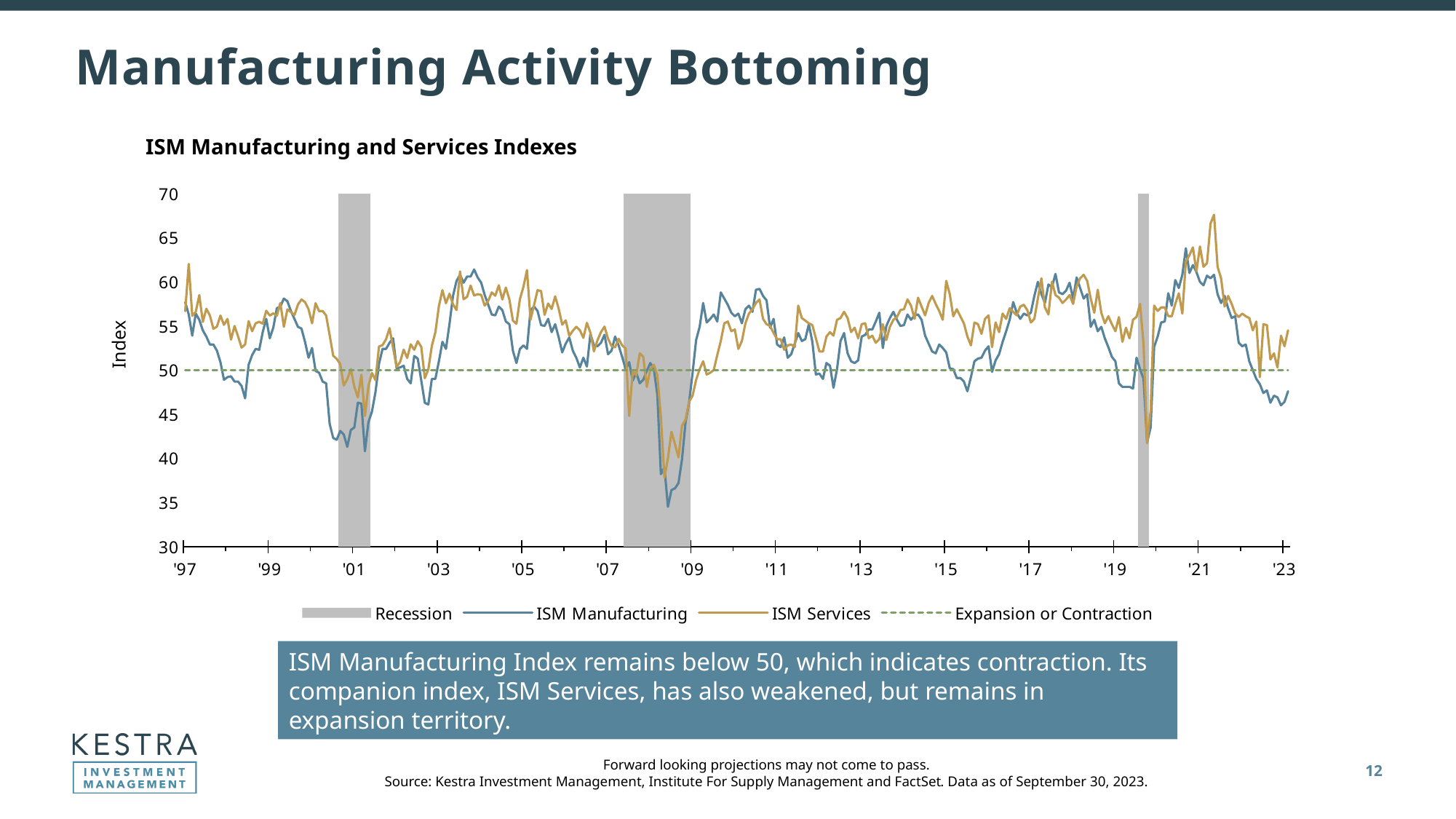
Between '21 and '23, does the ISM Manufacturing line rise or fall? fall At what level is the dashed 'Expansion or Contraction' line drawn? 50 What is the label on the chart's vertical axis? Index What kind of chart is shown on the slide? line chart How many entries does the chart's legend list? 4 What is the title of the chart? ISM Manufacturing and Services Indexes Is the peak value for ISM Services around '21 greater or less than 65? greater How many shaded recession periods are shown on the chart? 3 Is the value for ISM Services at the end of the series in '23 greater or less than 50? greater At the end of the series in '23, which is higher, ISM Manufacturing or ISM Services? ISM Services Is the value for ISM Manufacturing at the end of the series in '23 greater or less than 50? less